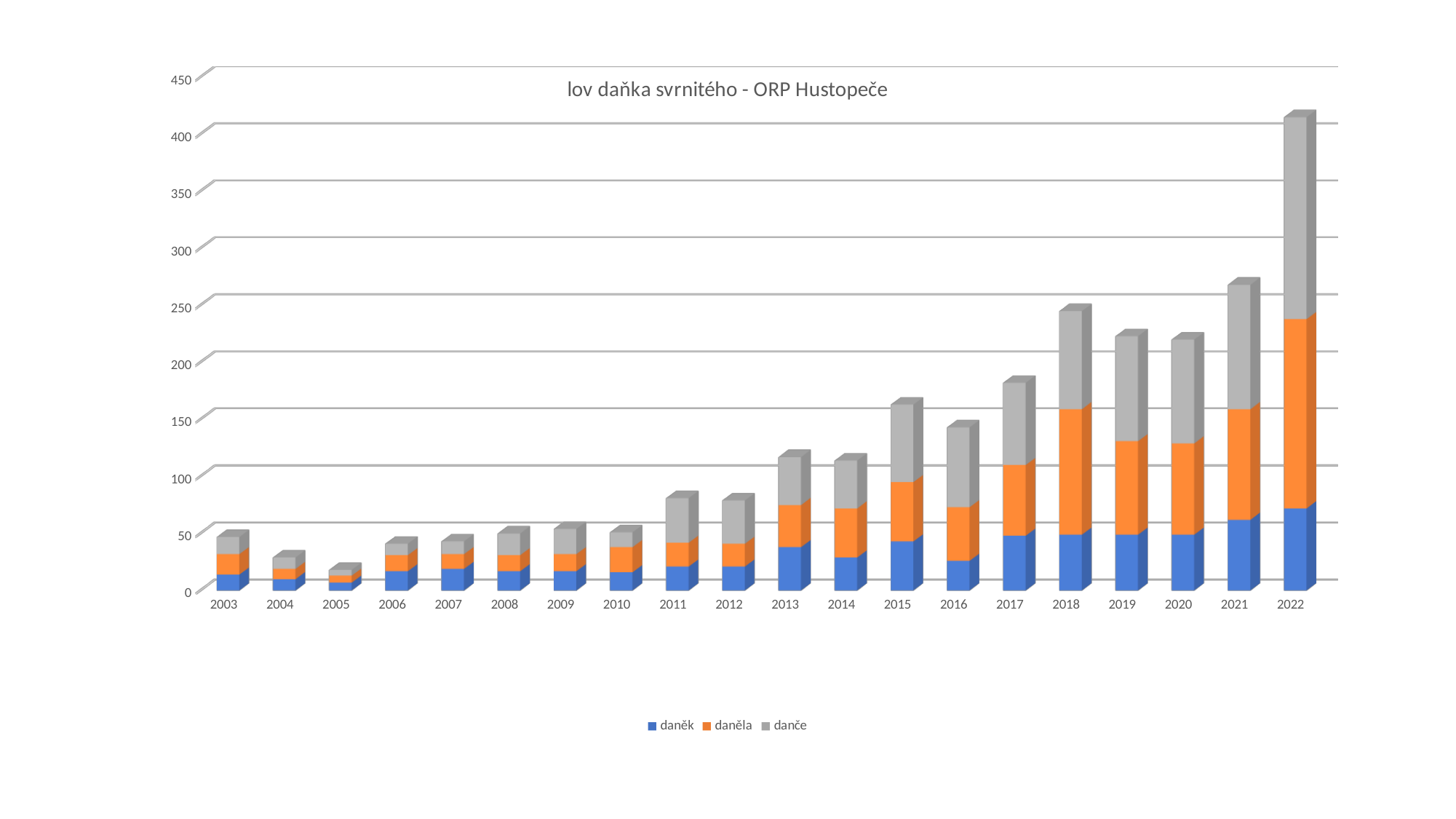
Which year has the lowest total bar? 2005 Is the total for 2018 greater or less than 200? greater Do the total bar heights generally rise or fall from 2003 to 2022? rise Which year has the larger total bar, 2017 or 2018? 2018 Which year has the highest total bar? 2022 Is the total for 2022 greater or less than 350? greater How many years are shown on the x axis? 20 What is the title of the chart? lov daňka svrnitého - ORP Hustopeče How many series does the legend list? 3 What kind of chart is shown on the slide? stacked bar chart Which year has the larger total bar, 2021 or 2022? 2022 Is the total for 2005 greater or less than 50? less